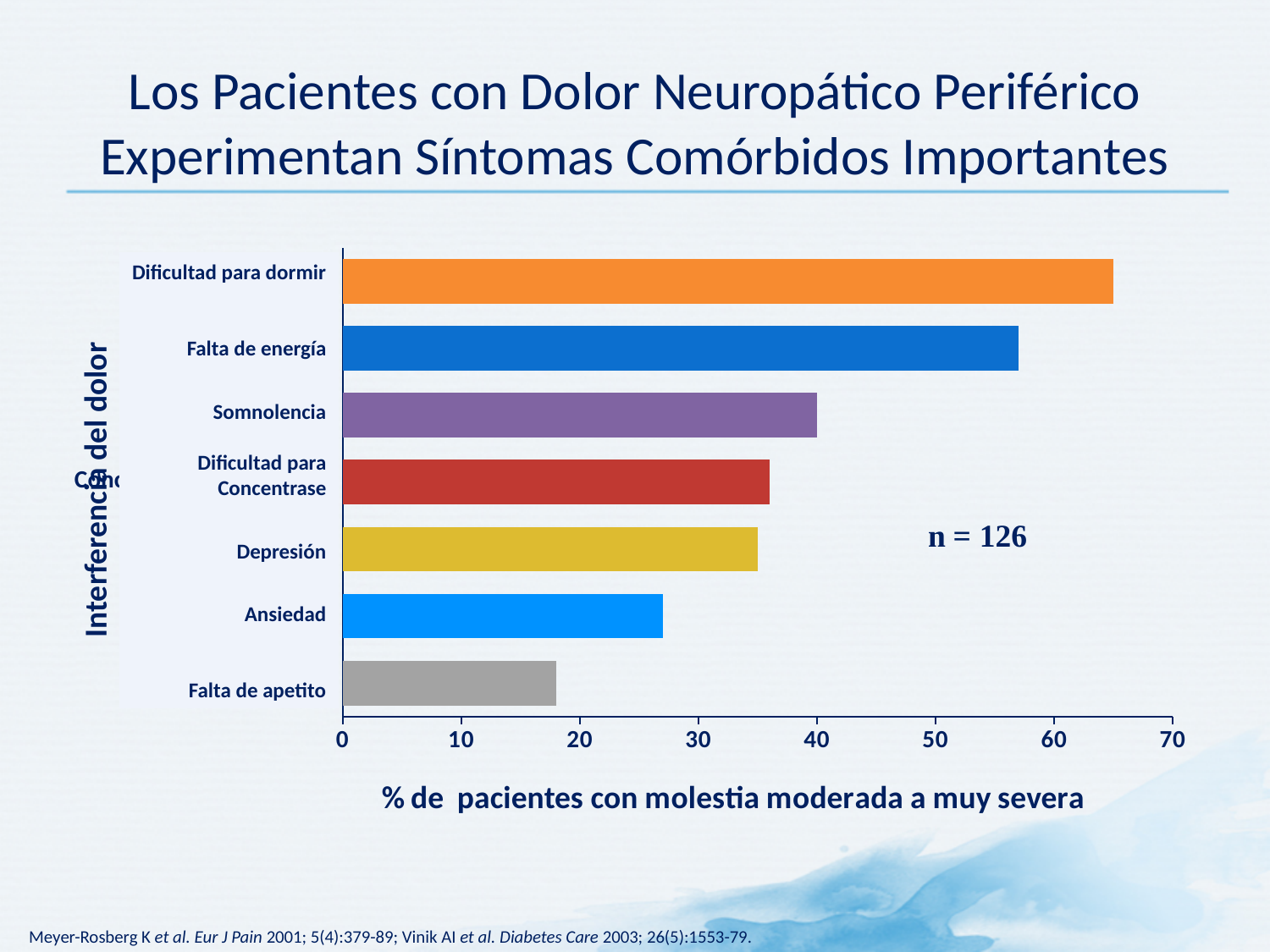
How many categories are plotted in the chart? 7 Which is larger, the value for Falta de energía or the value for Dificultad para Concentrase? Falta de energía Is the value for Falta de apetito greater or less than 20? less Is the value for Ansiedad greater or less than 30? less What kind of chart is shown on the slide? bar chart Is the value for Falta de energía greater or less than 50? greater What is the label of the horizontal axis of the chart? % de pacientes con molestia moderada a muy severa Which category has the lowest value in the chart? Falta de apetito Which category has the highest value in the chart? Dificultad para dormir Which is larger, the value for Somnolencia or the value for Ansiedad? Somnolencia